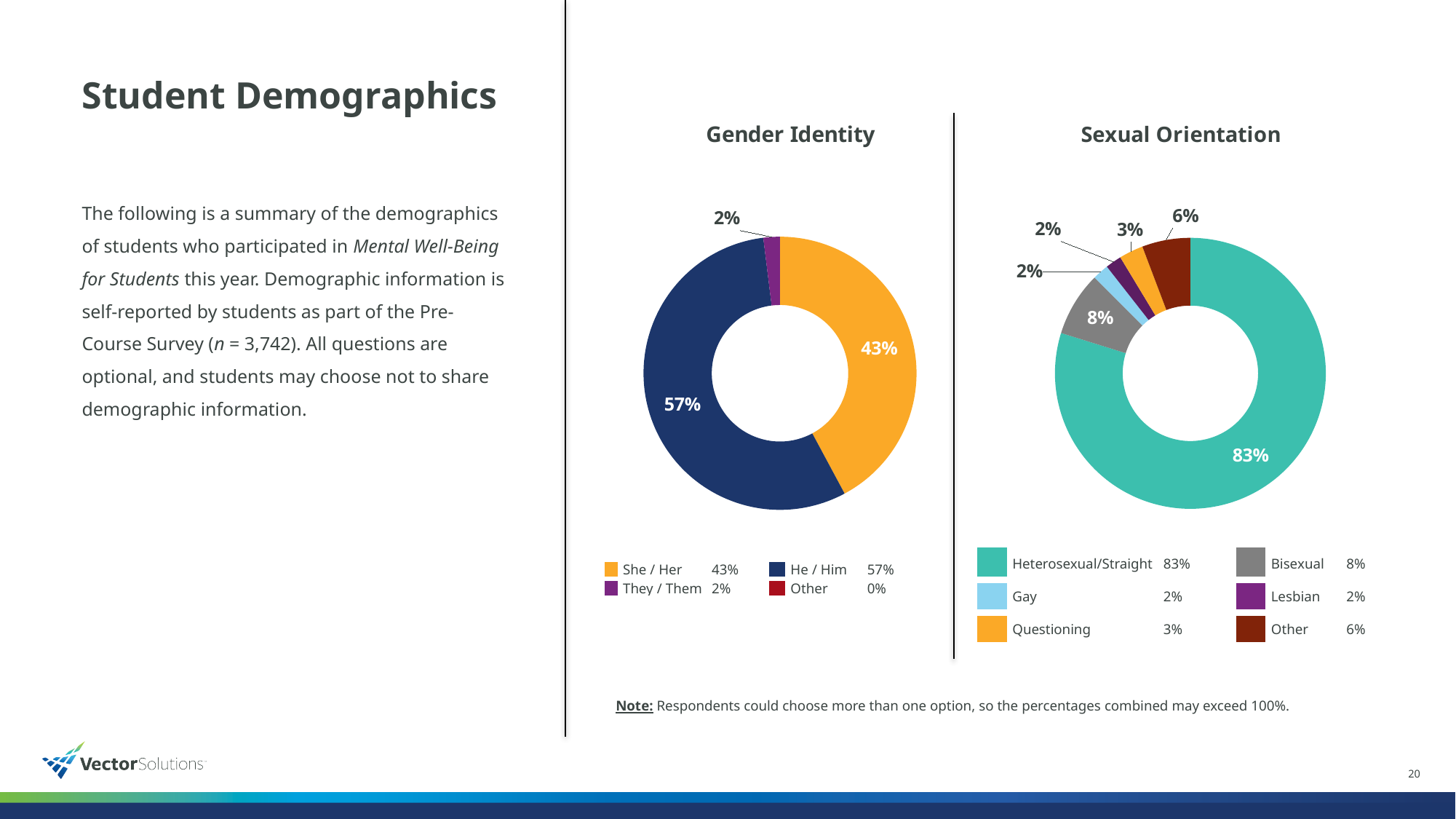
What kind of chart is the Sexual Orientation chart? Pie chart (donut) In the Gender Identity chart, what percentage of students selected She / Her? 43% In the Sexual Orientation chart, how many categories does the legend list? 6 In the Sexual Orientation chart, which is larger, the share for Bisexual or the share for Other? Bisexual In the Sexual Orientation chart, what colour represents Heterosexual/Straight? Teal In the Gender Identity chart, how many categories does the legend list? 4 In the Sexual Orientation chart, what percentage of students selected Bisexual? 8% In the Sexual Orientation chart, what percentage of students selected Questioning? 3% In the Gender Identity chart, which category has the largest share? He / Him In the Gender Identity chart, what is the difference between the He / Him and She / Her percentages? 14% In the Gender Identity chart, what percentage of students selected He / Him? 57% In the Sexual Orientation chart, what percentage of students selected Heterosexual/Straight? 83%